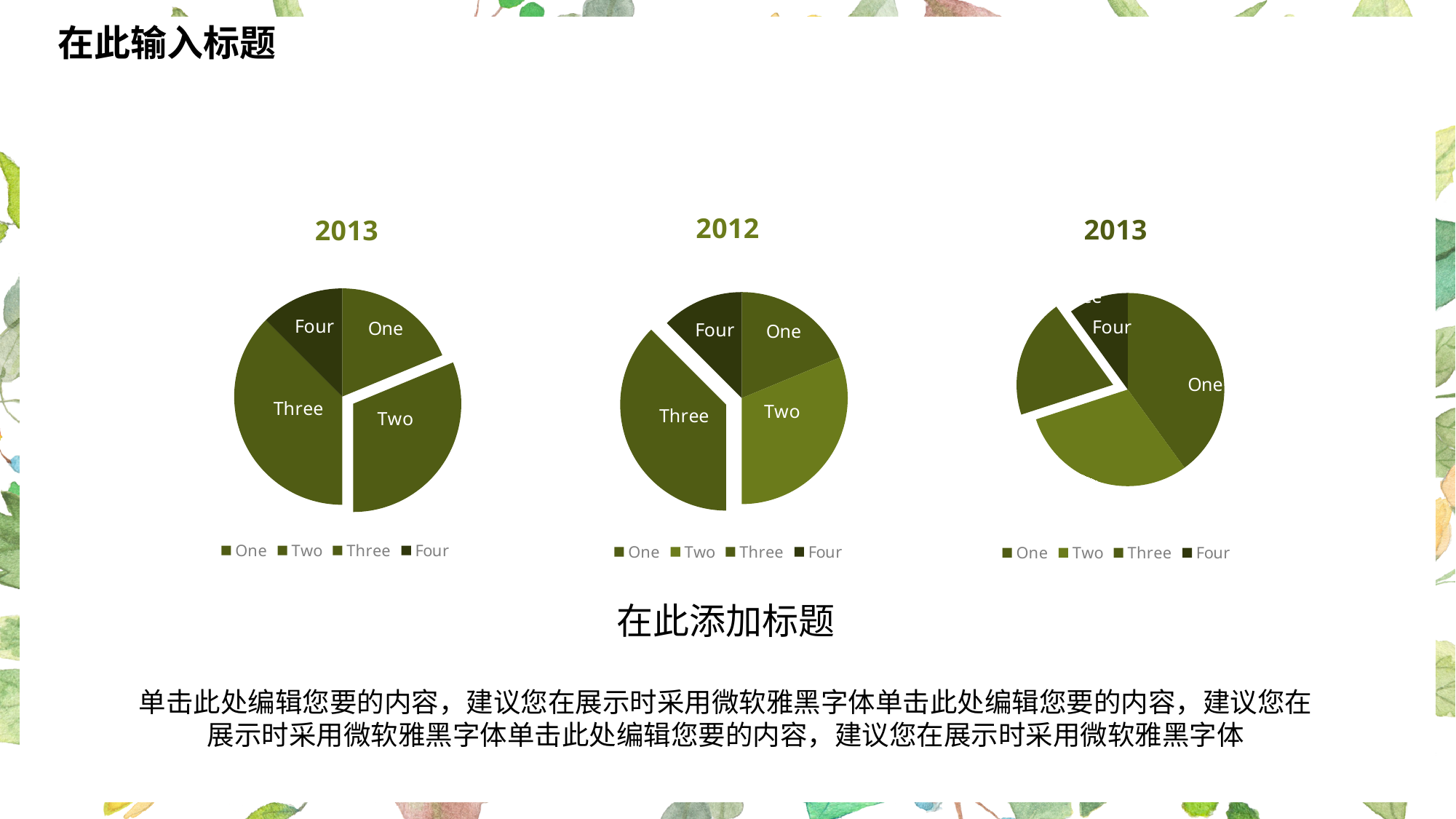
In the right-hand pie chart (2013), which slice is larger, One or Four? One In the left-hand pie chart (2013), which slice is larger, Three or One? Three What kind of chart is the left-hand chart titled 2013? pie chart In the middle pie chart (2012), which slice is larger, Two or One? Two In the left-hand pie chart (2013), which slice is pulled out from the rest of the pie? Two How many slices does the left-hand pie chart (2013) have? 4 In the middle pie chart (2012), which category has the largest slice? Three What is the title of the middle chart? 2012 How many pie charts are shown on the slide? 3 In the left-hand pie chart (2013), which category has the largest slice? Three How many entries does the legend of the middle chart (2012) list? 4